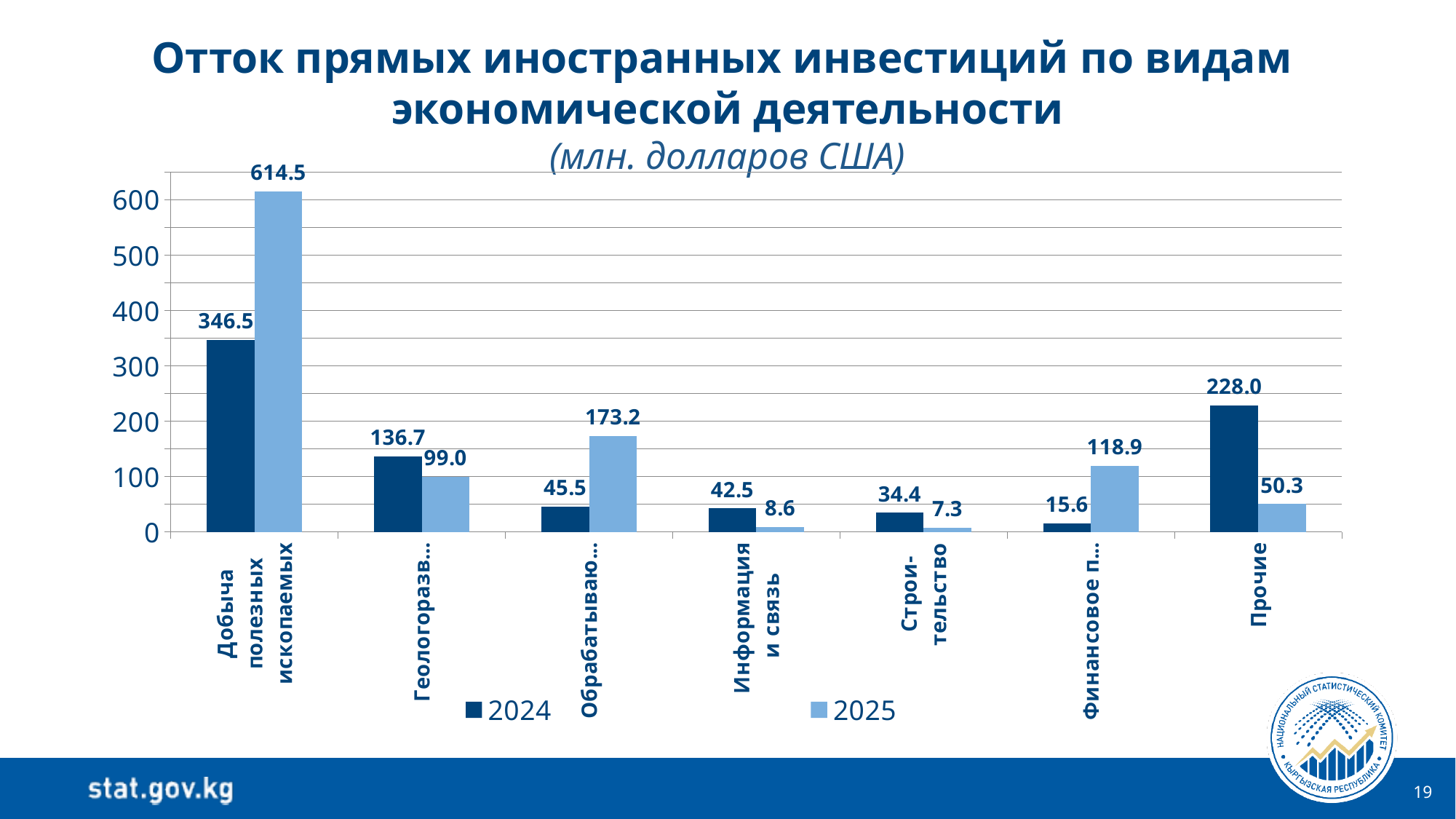
What is the 2025 value for Добыча полезных ископаемых? 614.5 Which category has the lowest 2025 value? Строительство What is the 2024 value for Строительство? 34.4 How many categories are shown on the x axis? 7 Which is larger for Прочие: the 2024 value or the 2025 value? 2024 How many series does the legend list? 2 Is the 2024 value for Добыча полезных ископаемых greater or less than 300? greater What is the 2025 value for Информация и связь? 8.6 Which category has the highest 2025 value? Добыча полезных ископаемых What is the difference between the 2025 and 2024 values for Добыча полезных ископаемых? 268.0 What is the 2024 value for Прочие? 228.0 What kind of chart is shown on the slide? bar chart